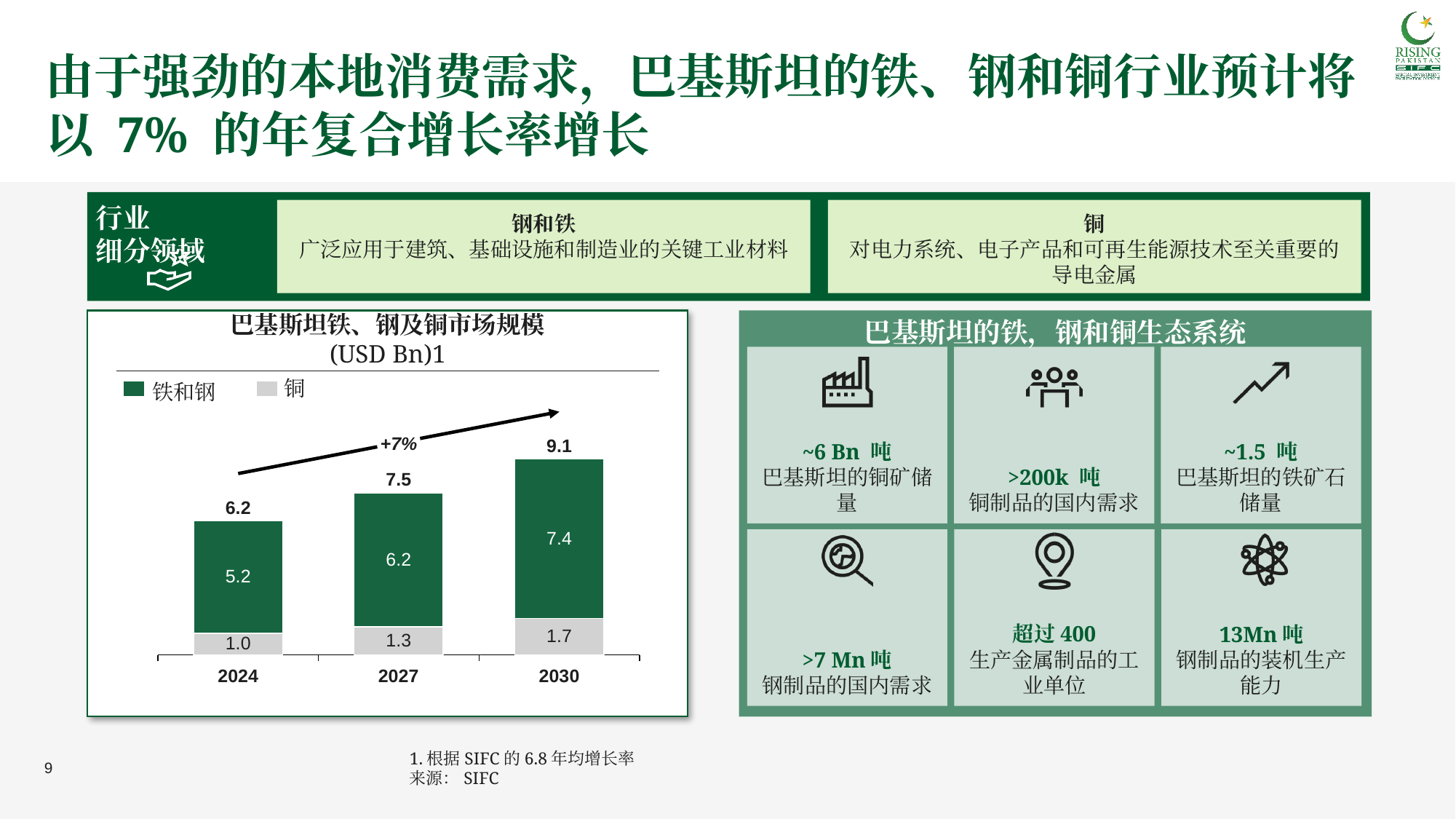
Do the total values rise or fall from 2024 to 2030? Rise Which is larger, the 铜 value in 2027 or in 2030? 2030 What is the difference between the 铁和钢 values for 2030 and 2024? 2.2 What is the total of the stacked bar for 2027? 7.5 Which year has the highest total market size? 2030 How many series does the legend list? 2 How many years are shown on the x axis? 3 What is the value for 铁和钢 in 2024? 5.2 What is the value for 铜 in 2030? 1.7 Which year has the lowest value for 铜? 2024 What is the value for 铁和钢 in 2027? 6.2 What kind of chart is shown? Stacked bar chart